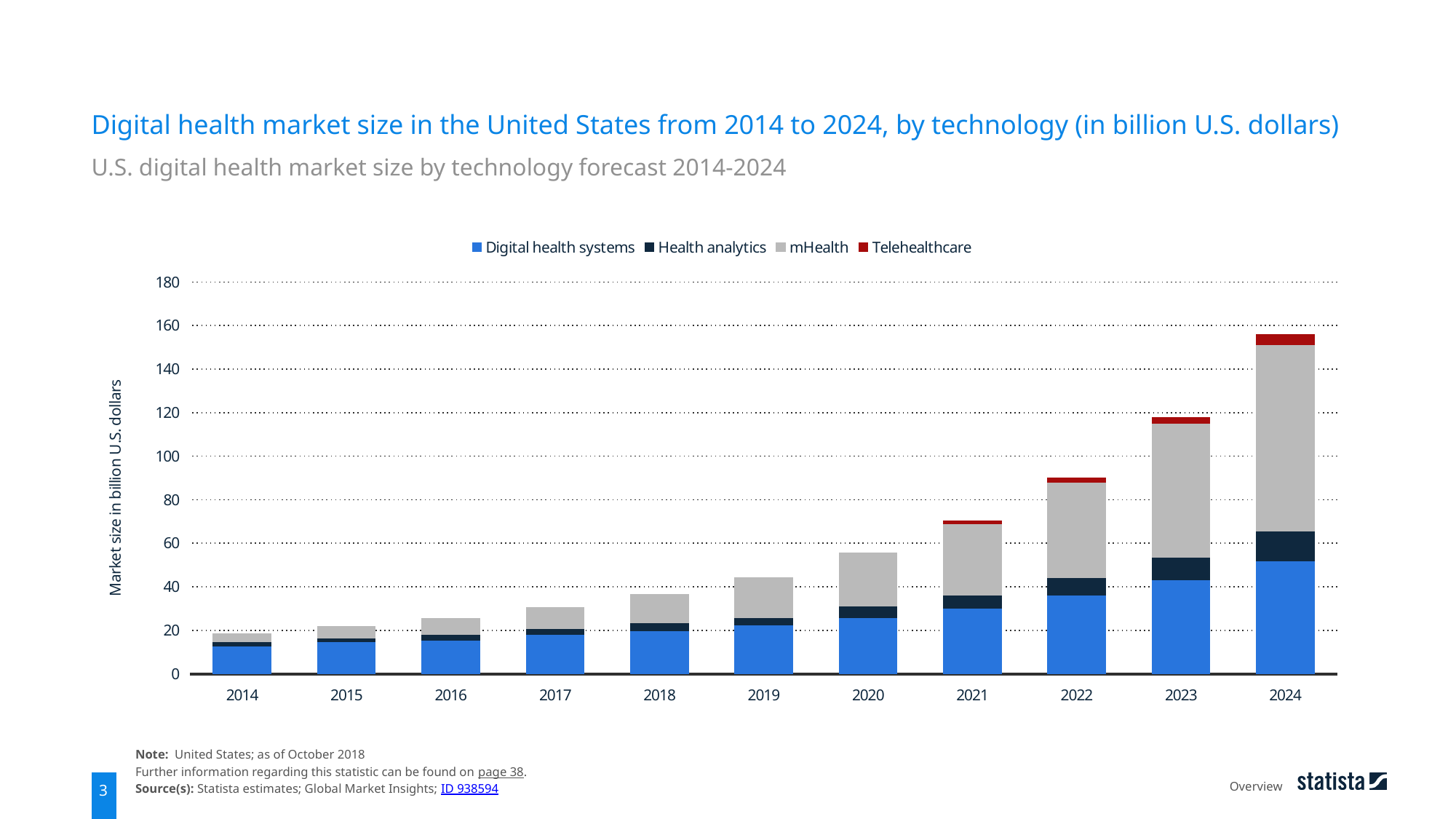
What colour represents Telehealthcare in the legend? Red Is the total market size for 2022 greater or less than 80? greater Do the total market size values rise or fall from 2014 to 2024? Rise Which year has the lowest total digital health market size? 2014 Is the total market size for 2024 greater or less than 140? greater Is the total market size for 2020 greater or less than 60? less How many series does the legend list? 4 What kind of chart is shown on the slide? Stacked bar chart Which year has the larger total market size, 2019 or 2022? 2022 How many years are shown on the x axis? 11 Which year has the highest total digital health market size? 2024